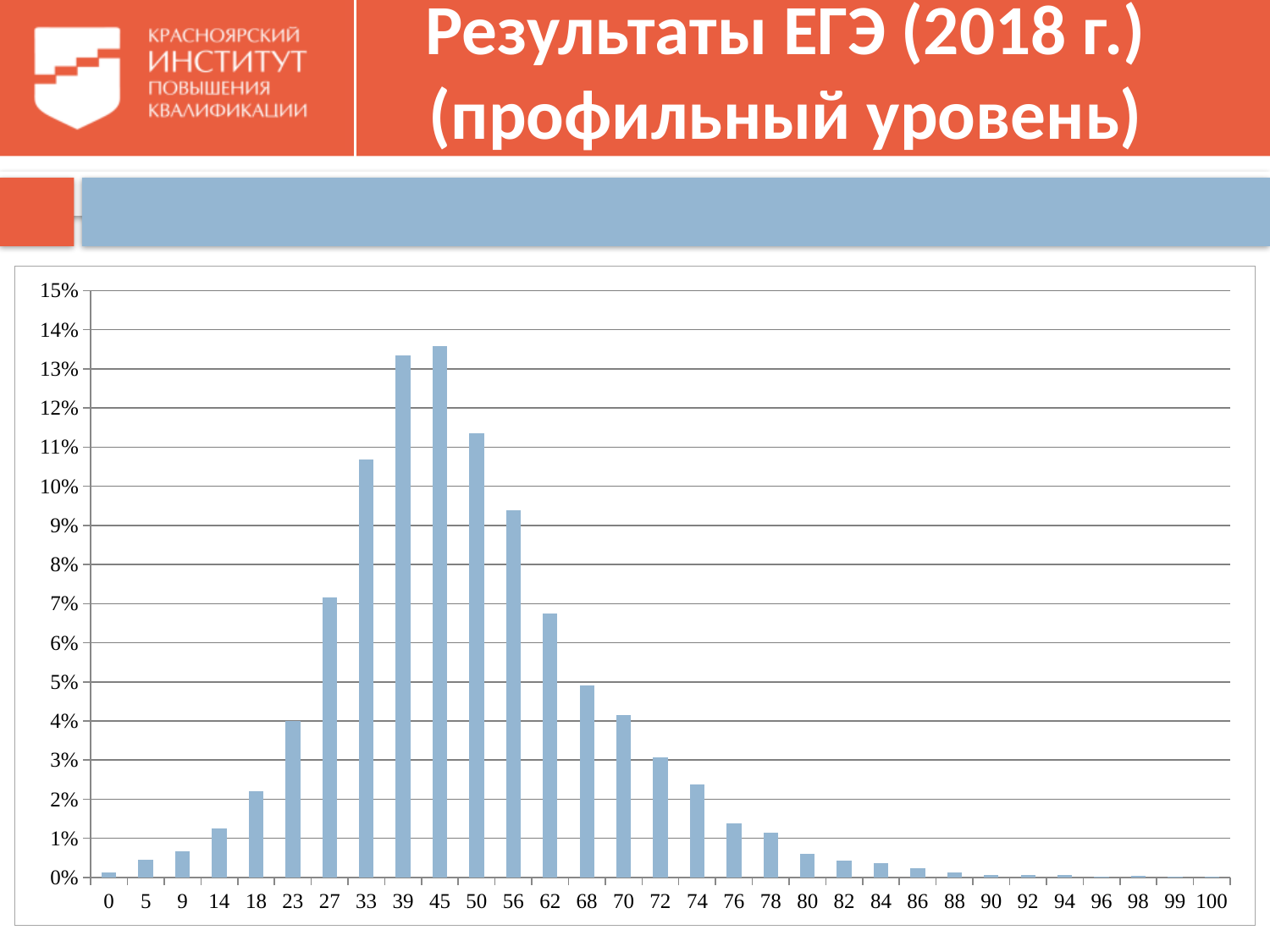
Do the values rise or fall along the x axis from score 0 to score 45? rise Which has the larger value, score 33 or score 56? 33 Is the value for score 62 greater or less than 6%? greater Is the value for score 27 greater or less than 6%? greater What kind of chart is shown on the slide? bar chart How many score categories are shown along the x axis of the chart? 31 Do the values rise or fall along the x axis from score 45 to score 100? fall Is the value for score 56 greater or less than 9%? greater Which has the larger value, score 39 or score 50? 39